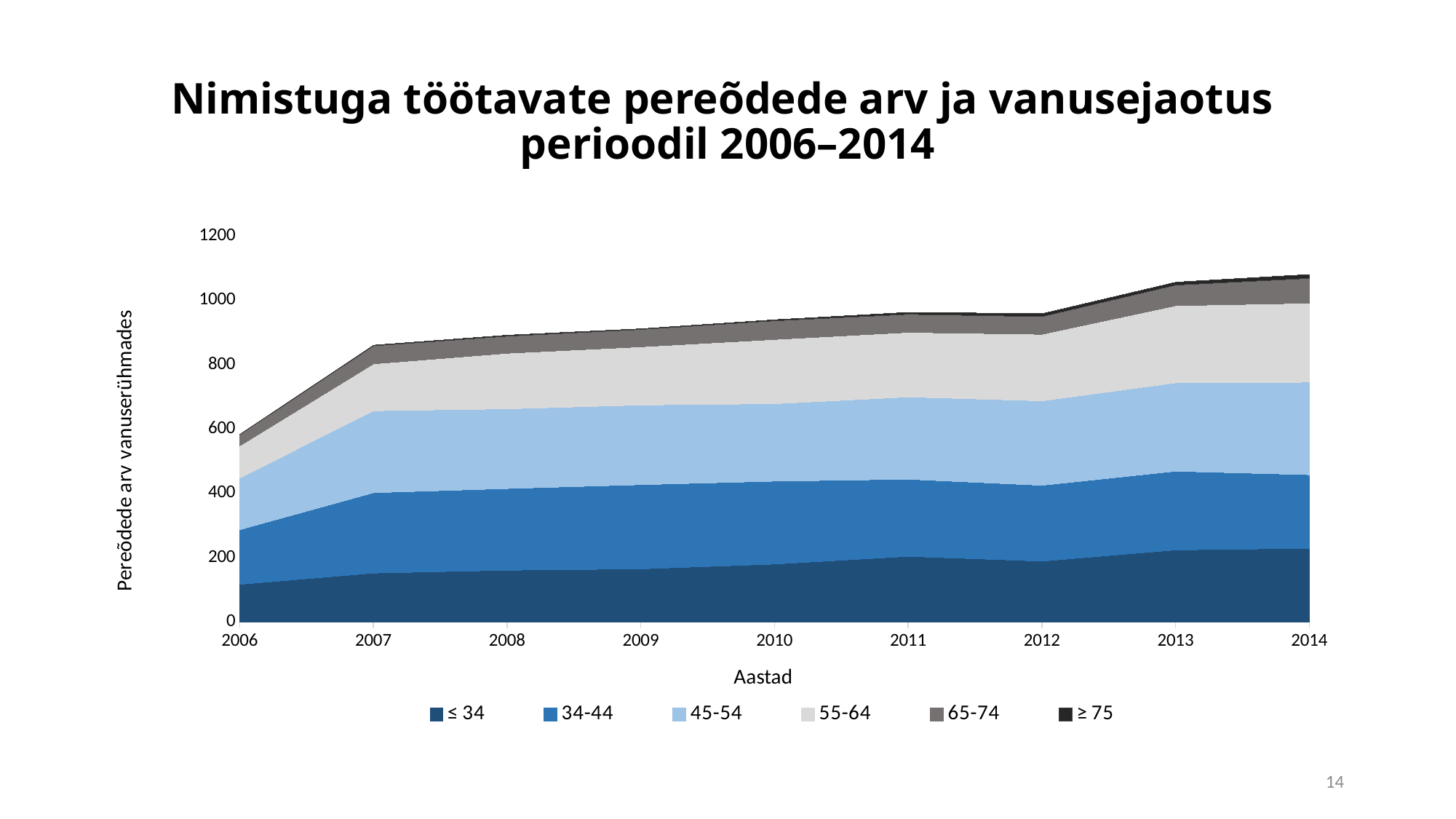
Is the total value for 2006 greater or less than 800? less Which year has the highest total value? 2014 What kind of chart is shown on the slide? stacked area chart What is the label of the x axis? Aastad Does the total number of family nurses rise or fall from 2006 to 2014? rise Is the value for the ≤ 34 series in 2006 greater or less than 200? less How many years are shown along the x axis? 9 Which year has the lowest total value? 2006 Is the total value for 2012 greater or less than 1000? less How many series does the legend list? 6